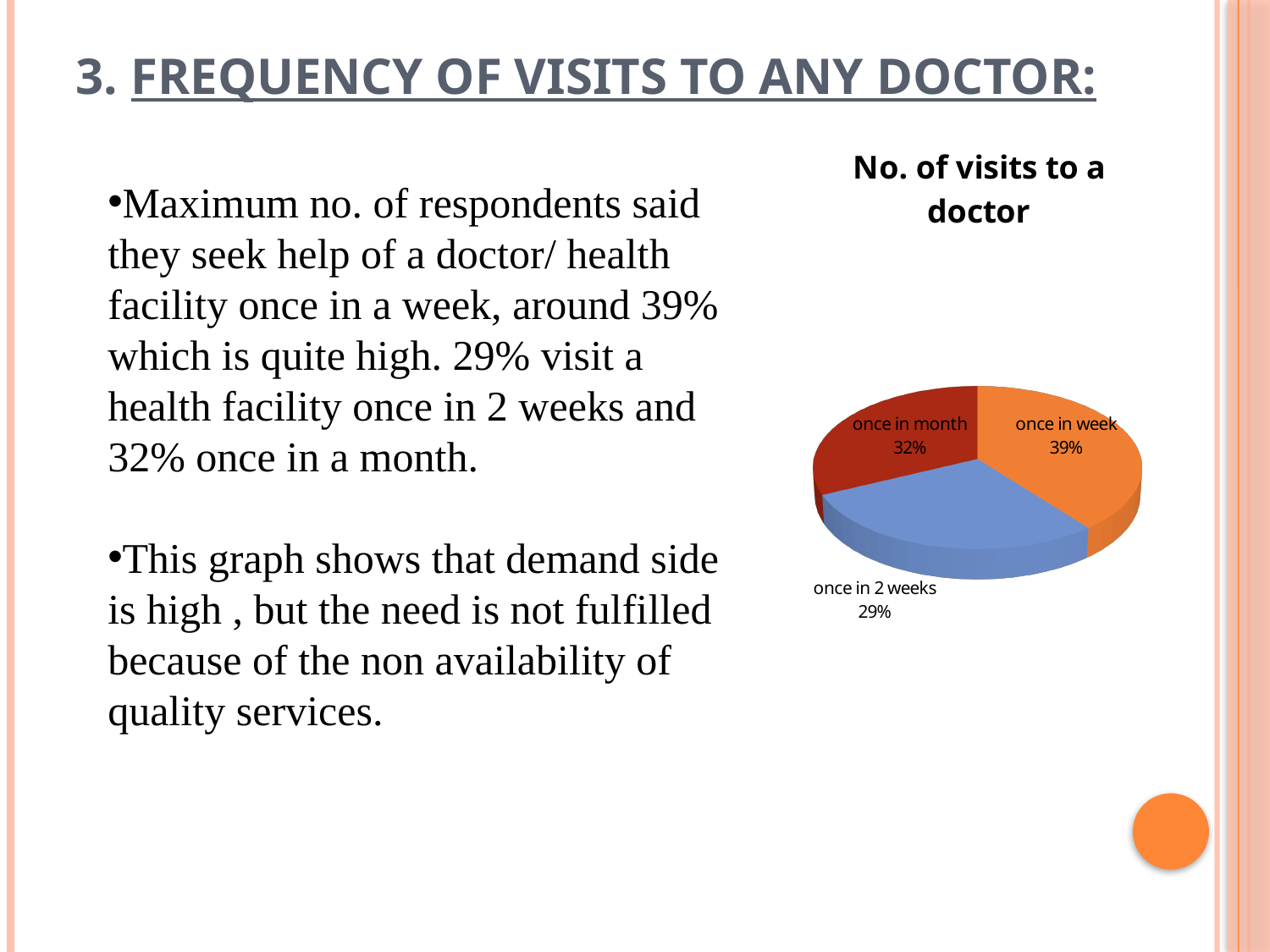
What percentage of respondents visit a doctor once in 2 weeks? 29% Which is larger, the share for 'once in month' or the share for 'once in 2 weeks'? once in month What colour is the 'once in week' slice? orange Which category has the smallest share of the pie? once in 2 weeks What kind of chart is shown on the slide? pie chart What is the title of the chart? No. of visits to a doctor What percentage of respondents visit a doctor once in a month? 32% Which category has the largest share of the pie? once in week What percentage of respondents visit a doctor once in a week? 39% What is the difference in percentage points between 'once in month' and 'once in 2 weeks'? 3 How many slices does the pie chart have? 3 What is the difference in percentage points between 'once in week' and 'once in 2 weeks'? 10